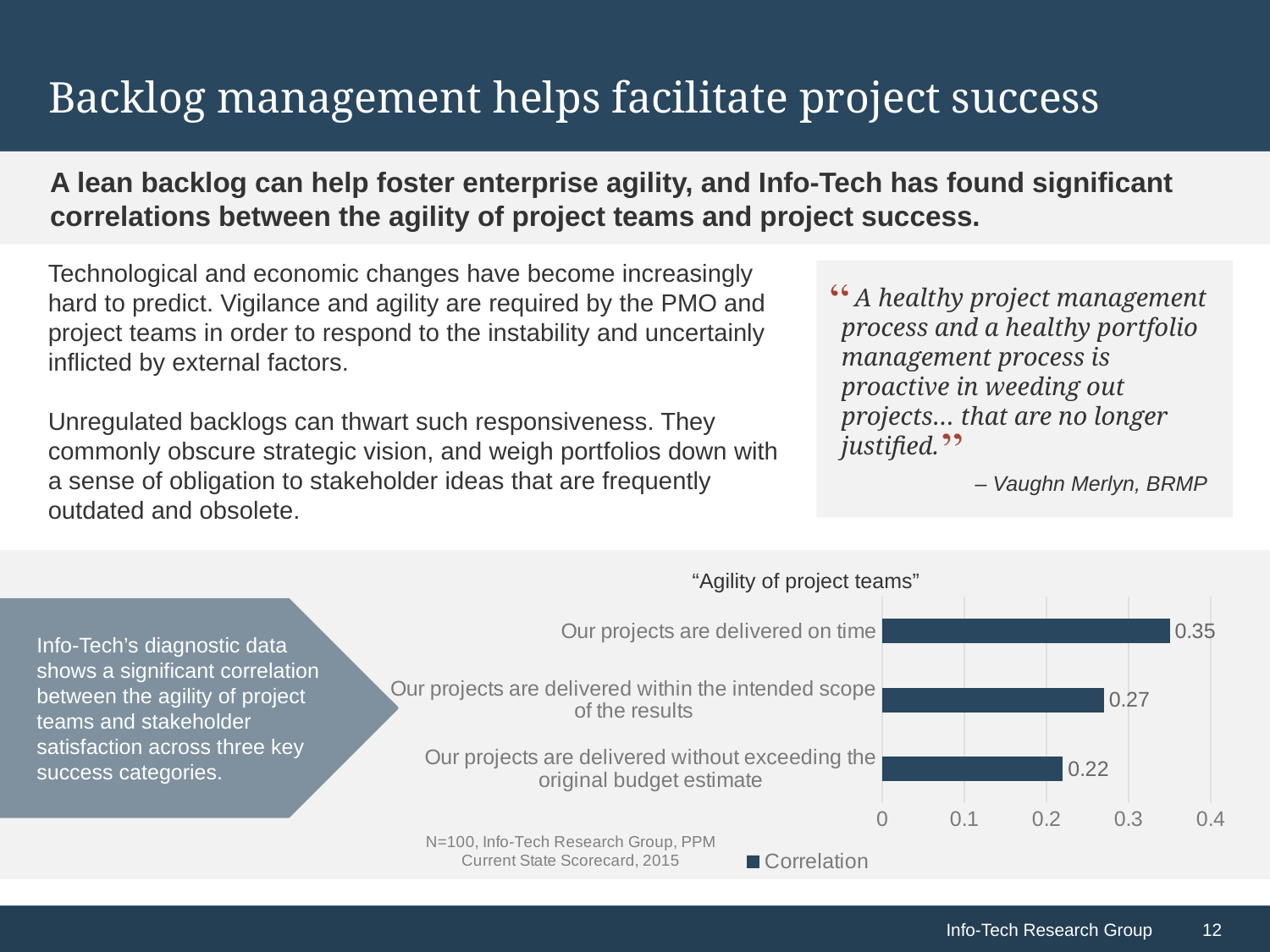
What is the correlation value for "Our projects are delivered without exceeding the original budget estimate"? 0.22 What is the difference between the correlation for "Our projects are delivered on time" and "Our projects are delivered without exceeding the original budget estimate"? 0.13 Is the correlation value for "Our projects are delivered on time" greater or less than 0.3? greater Which category has the lowest correlation value? Our projects are delivered without exceeding the original budget estimate What is the correlation value for "Our projects are delivered within the intended scope of the results"? 0.27 What is the correlation value for "Our projects are delivered on time"? 0.35 How many categories are shown in the chart? 3 Which category has the highest correlation value? Our projects are delivered on time What kind of chart is shown on the slide? Bar chart What is the title of the chart? "Agility of project teams" Which has a larger correlation value: "Our projects are delivered within the intended scope of the results" or "Our projects are delivered without exceeding the original budget estimate"? Our projects are delivered within the intended scope of the results How many series does the legend list? 1